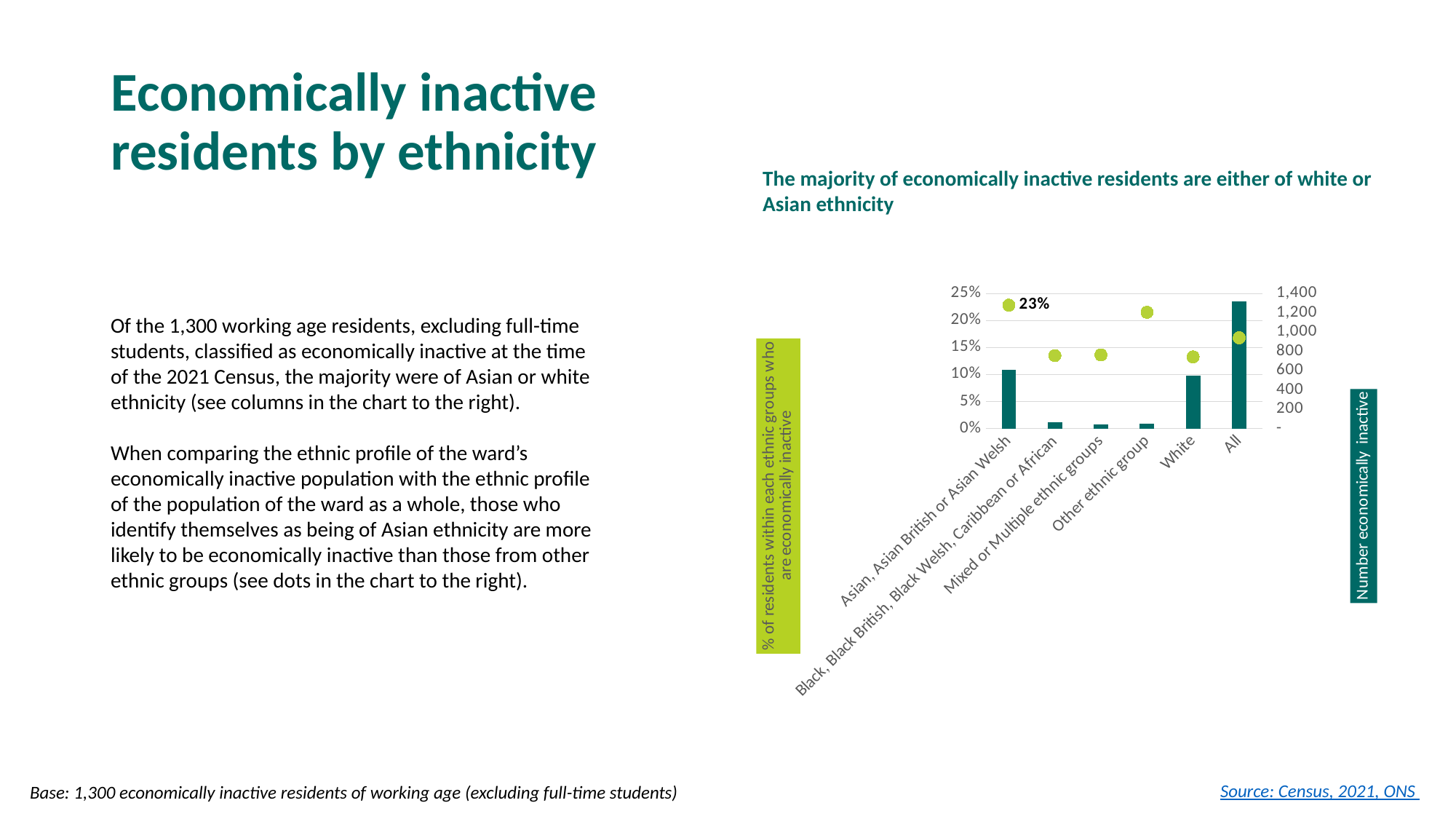
Is the dot for White greater or less than 15% on the left-hand axis? less Is the bar for Asian, Asian British or Asian Welsh greater or less than 400 on the right-hand axis? greater Is the dot for Other ethnic group greater or less than 20% on the left-hand axis? greater What percentage of residents in the Asian, Asian British or Asian Welsh group are economically inactive, according to the data label on the dot? 23% What does the right-hand vertical axis of the chart measure? Number economically inactive Which has the higher percentage economically inactive (dot): Asian, Asian British or Asian Welsh, or White? Asian, Asian British or Asian Welsh How many categories are shown along the x axis of the chart? 6 What kind of chart is shown on the slide? Bar chart with dot markers (combination chart) Which category has the tallest bar for the number economically inactive? All Which bar is taller: All or White? All